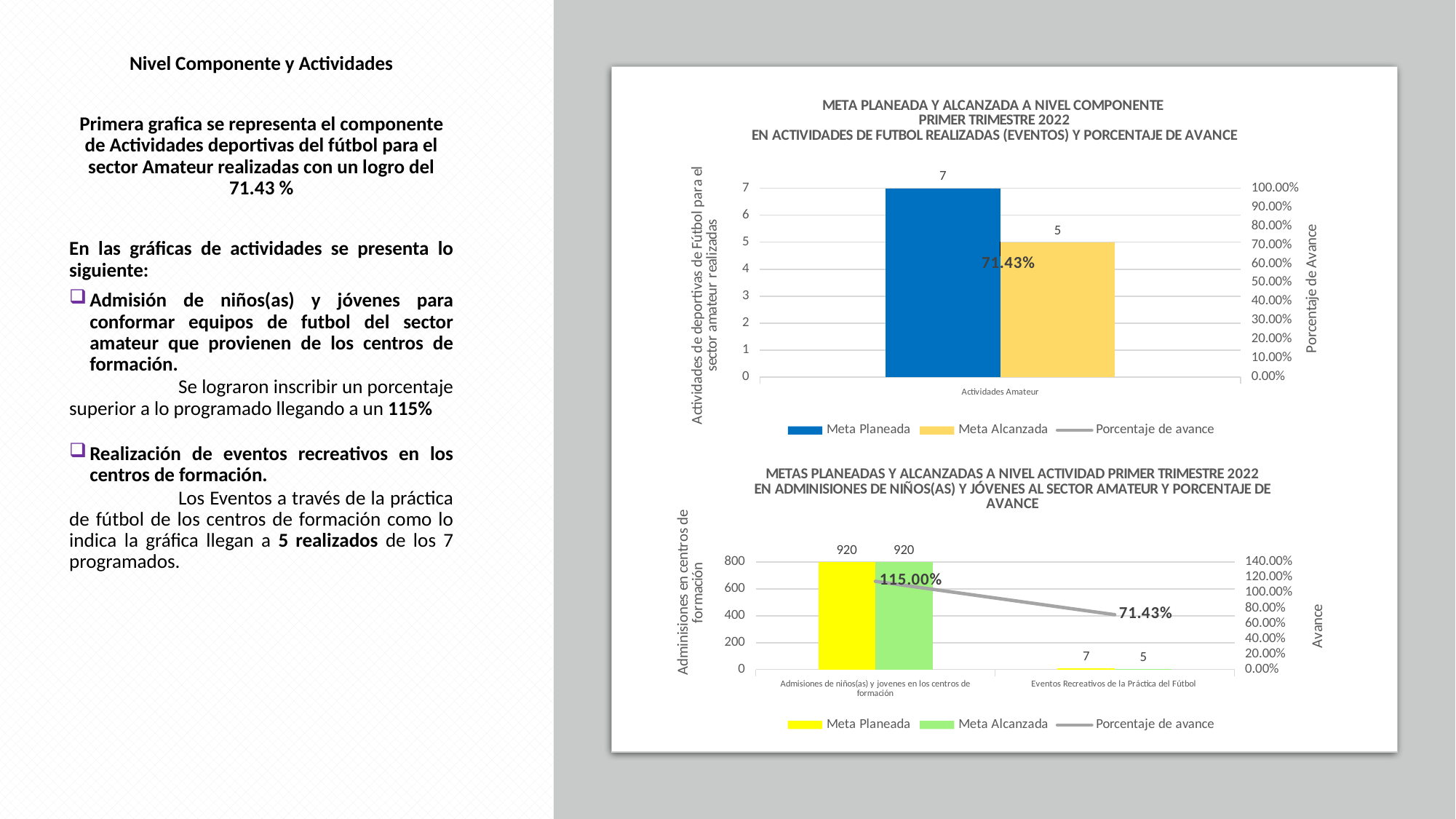
In the bottom chart, how many categories are shown on the x axis? 2 In the bottom chart, what colour represents Meta Planeada? Yellow In the bottom chart, what Porcentaje de avance is shown for Eventos Recreativos de la Práctica del Fútbol? 71.43% In the top chart, what is the value of Meta Alcanzada for Actividades Amateur? 5 In the bottom chart, what Porcentaje de avance is shown for Admisiones de niños(as) y jovenes en los centros de formación? 115.00% In the top chart, how many series does the legend list? 3 In the bottom chart, which category has the higher Porcentaje de avance? Admisiones de niños(as) y jovenes en los centros de formación In the top chart, what is the difference between Meta Planeada and Meta Alcanzada? 2 In the top chart, what is the value of Meta Planeada for Actividades Amateur? 7 In the bottom chart, what is the Meta Alcanzada value for Eventos Recreativos de la Práctica del Fútbol? 5 In the top chart, what Porcentaje de avance is shown for Actividades Amateur? 71.43%